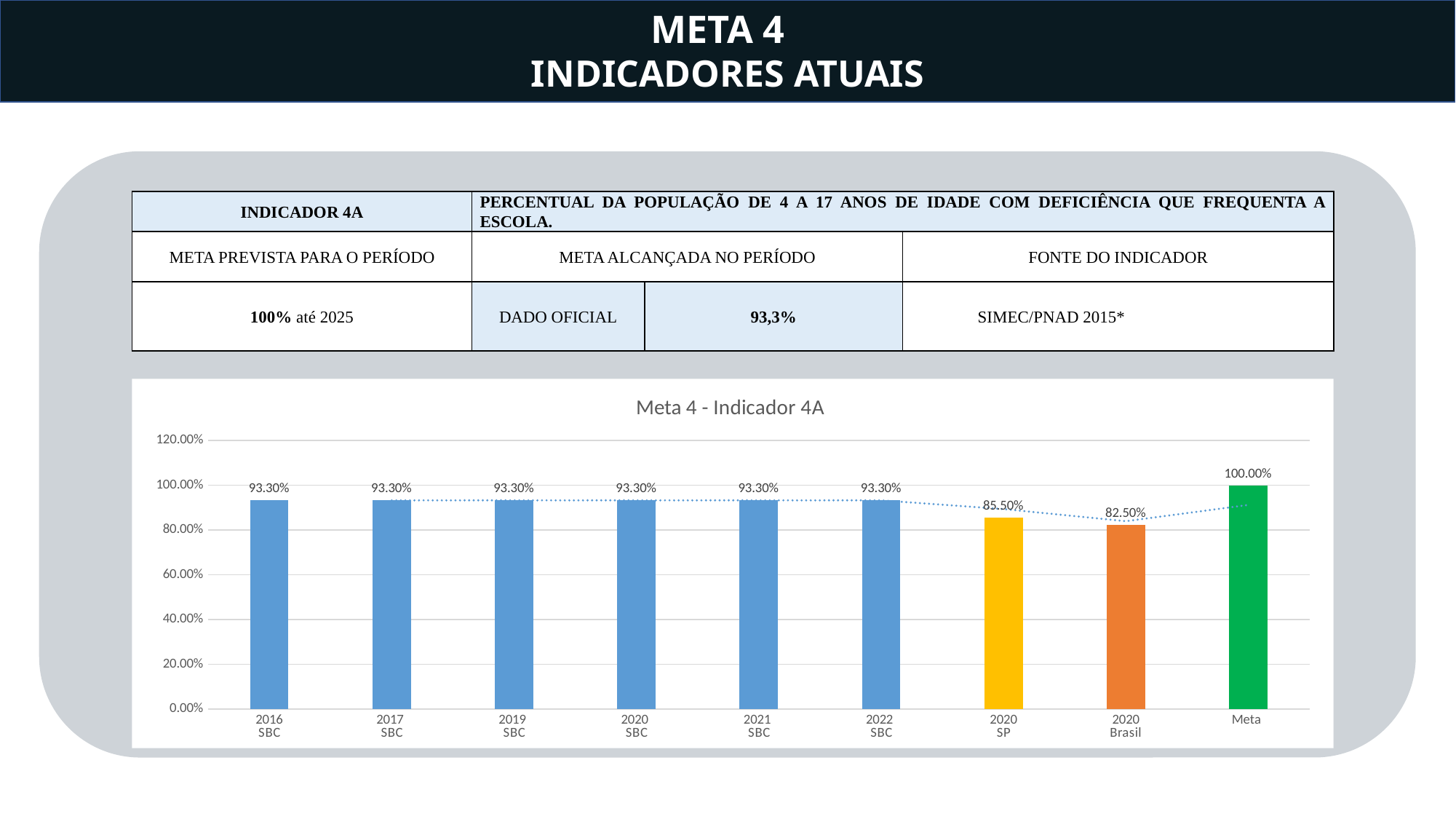
What is the value for 2020 Brasil in the chart? 82.50% What is the value for the Meta bar in the chart? 100.00% What kind of chart is shown on the slide? Bar chart What is the value for 2016 SBC in the chart? 93.30% What is the difference between the 2020 SP value and the 2020 Brasil value? 3.00% What is the title of the chart? Meta 4 - Indicador 4A What is the difference between the Meta value and the 2022 SBC value? 6.70% What is the value for 2020 SP in the Meta 4 - Indicador 4A chart? 85.50% Which is larger, the value for 2020 SP or the value for 2020 Brasil? 2020 SP How many bars are plotted in the chart? 9 Which category has the lowest value in the chart? 2020 Brasil Which category has the highest value in the chart? Meta